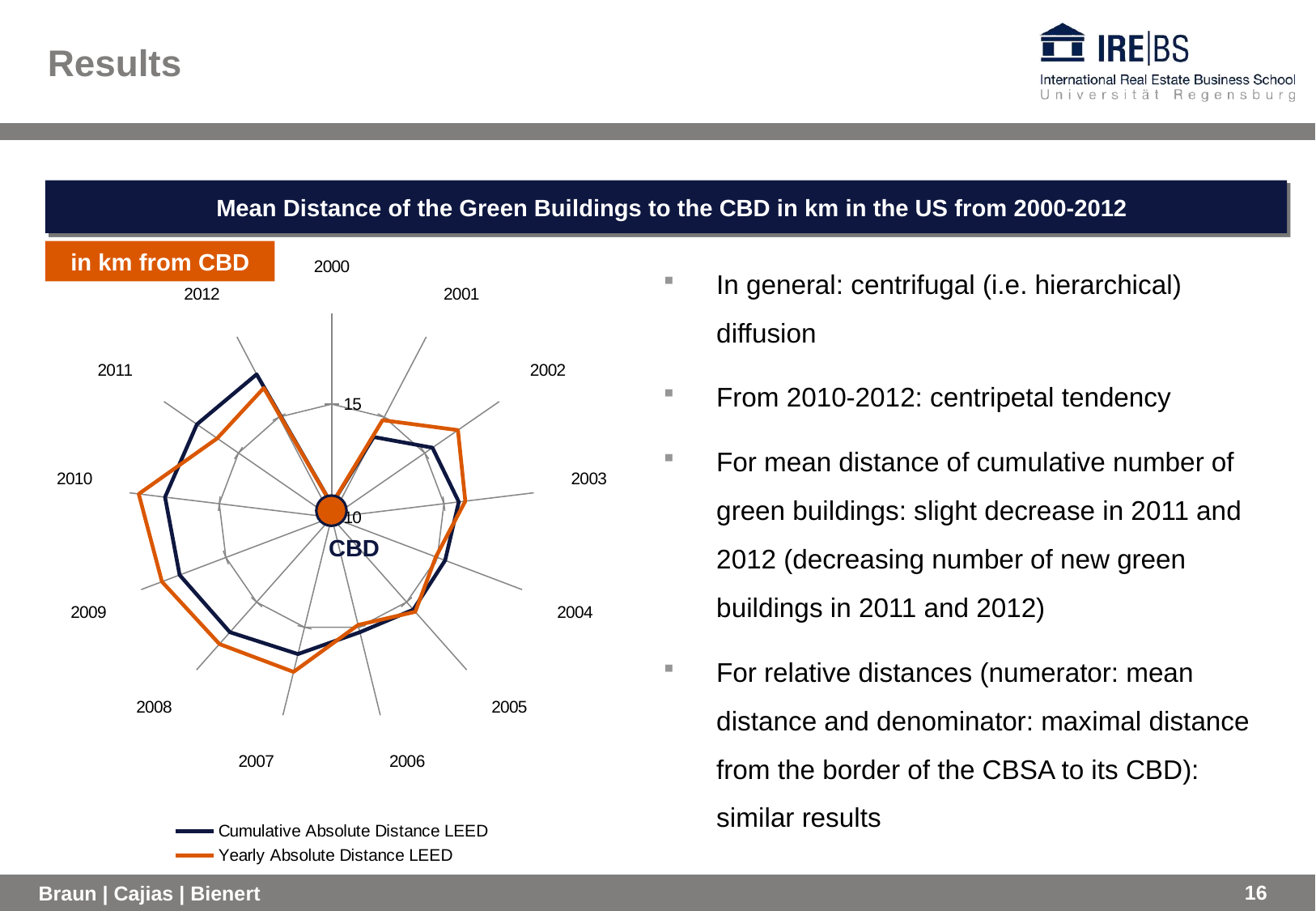
For 2012, which series has the larger value, Cumulative Absolute Distance LEED or Yearly Absolute Distance LEED? Cumulative Absolute Distance LEED Is the Yearly Absolute Distance LEED value for 2010 greater or less than 15? greater What kind of chart is shown on the slide? Radar chart What is the title of the chart? Mean Distance of the Green Buildings to the CBD in km in the US from 2000-2012 Which year has the lowest value for the Yearly Absolute Distance LEED series? 2000 Which year has the lowest value for the Cumulative Absolute Distance LEED series? 2000 Is the Cumulative Absolute Distance LEED value for 2008 greater or less than 15? greater How many series does the legend list? 2 How many years are plotted around the chart? 13 Is the Yearly Absolute Distance LEED value for 2000 greater or less than 15? less Which series is drawn in orange? Yearly Absolute Distance LEED For 2010, which series has the larger value, Cumulative Absolute Distance LEED or Yearly Absolute Distance LEED? Yearly Absolute Distance LEED